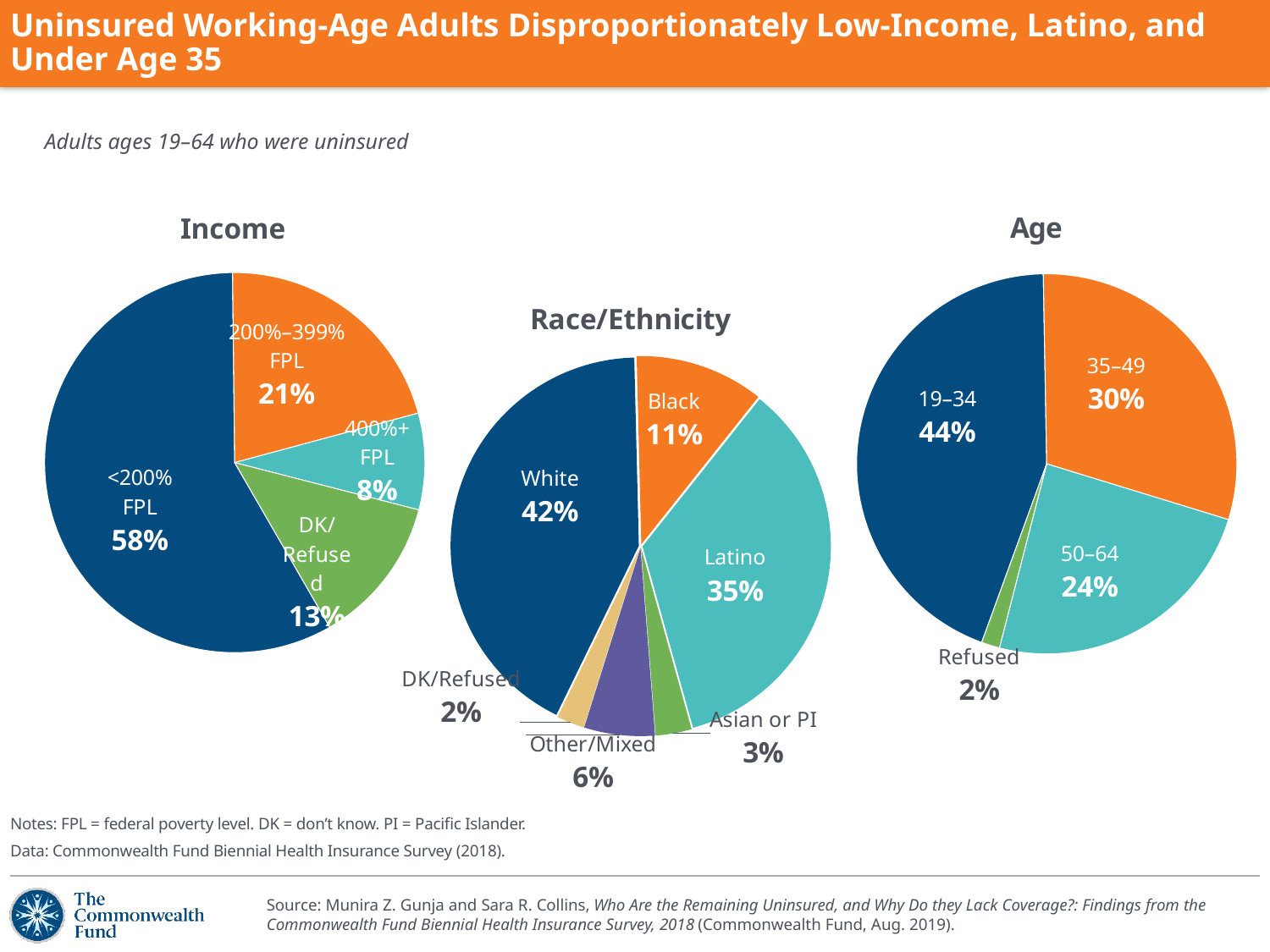
In the Age pie chart, what is the difference between the 19–34 share and the 35–49 share? 14 percentage points What type of chart is used for the Income, Race/Ethnicity, and Age breakdowns? Pie chart In the Race/Ethnicity pie chart, which group has the largest share? White In the Income pie chart, which income category has the smallest share? 400%+ FPL In the Age pie chart, which age group has the largest share? 19–34 How many pie charts are on the slide? 3 In the Race/Ethnicity pie chart, which is larger, the Black share or the Other/Mixed share? Black In the Income pie chart, what share of uninsured adults had income below 200% FPL? 58% In the Race/Ethnicity pie chart, how many categories are shown? 6 In the Age pie chart, what share of uninsured adults were ages 50–64? 24% In the Income pie chart, what is the difference between the 200%–399% FPL share and the DK/Refused share? 8 percentage points In the Race/Ethnicity pie chart, what share is Latino? 35%